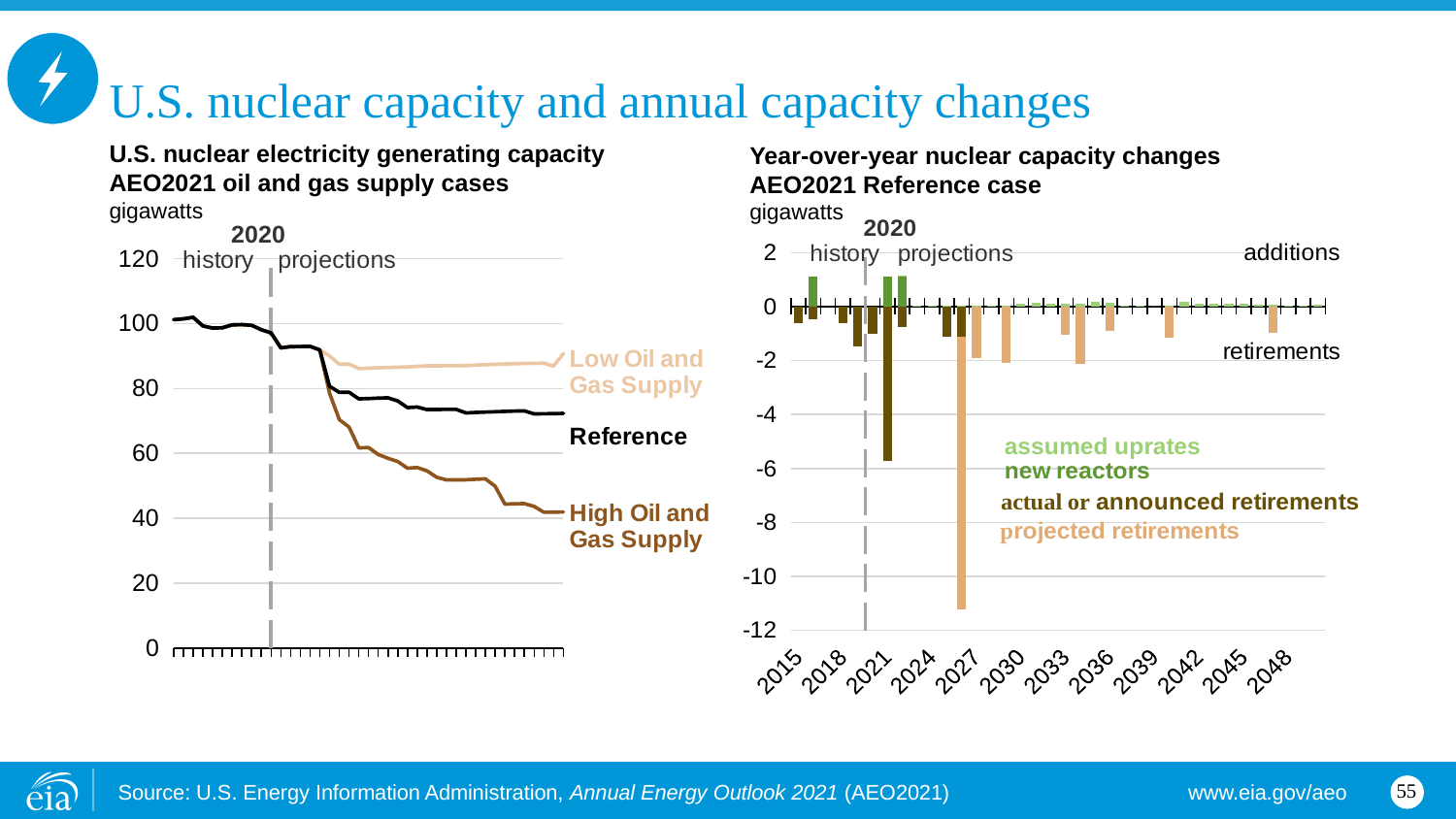
What unit is used on the y axis of both charts? gigawatts What kind of chart is the right chart, 'Year-over-year nuclear capacity changes'? bar chart In the left chart, is the value of the Reference line at the end of the projection period greater or less than 80? less In the left chart, is the value of the Low Oil and Gas Supply line at the end of the projection period greater or less than 80? greater In the left chart, which line is higher at the end of the projection period, Reference or High Oil and Gas Supply? Reference In the right chart, is the largest negative bar (around 2026) greater or less than -10? less In the right chart, which series does the largest negative bar (around 2026) belong to? projected retirements In the right chart, how many series does the legend list? 4 In the left chart, does the Reference line generally rise or fall over the projection period? fall In the left chart, how many series (cases) are plotted? 3 What kind of chart is the left chart, 'U.S. nuclear electricity generating capacity'? line chart